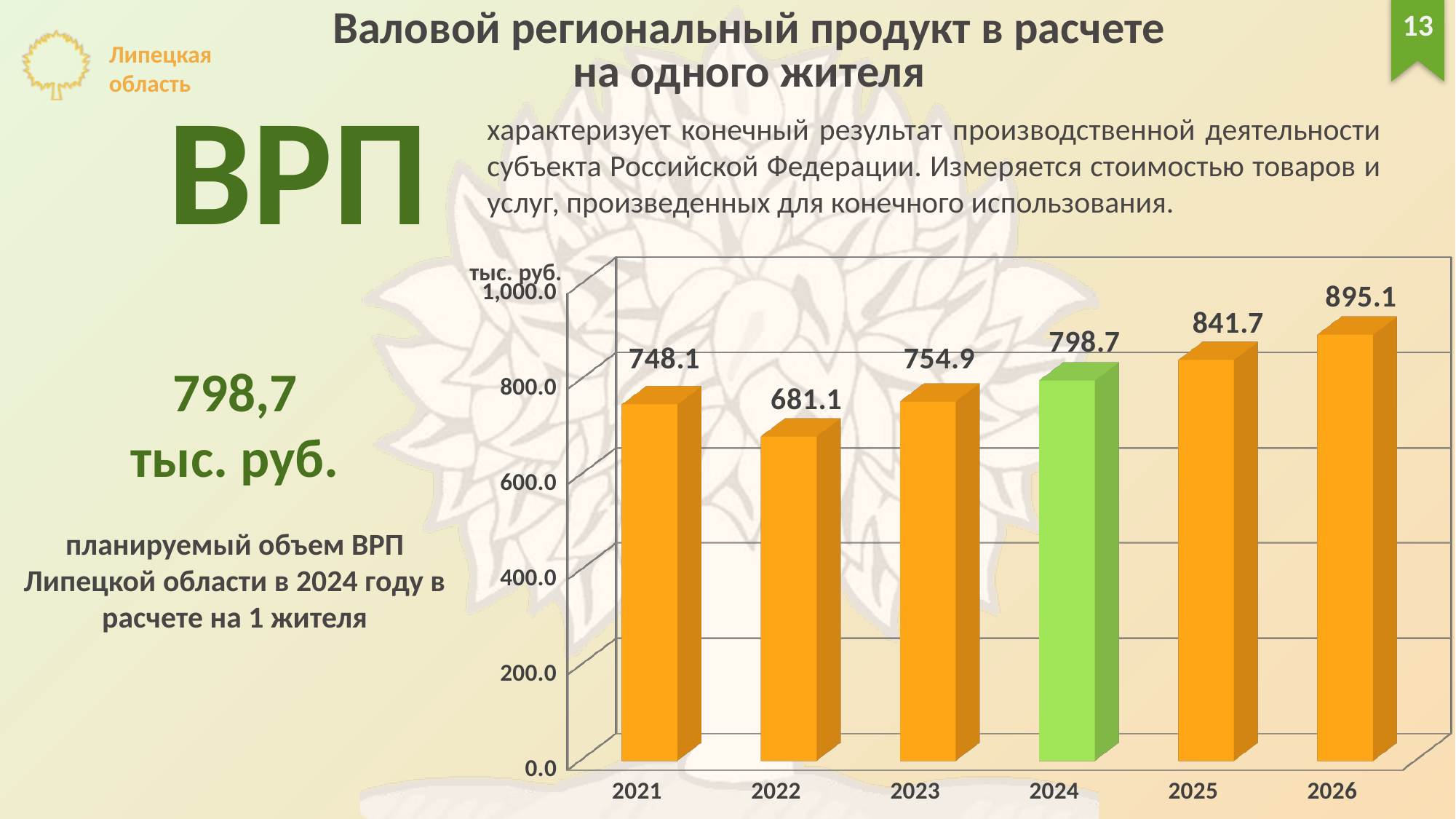
Which year has the highest value on the chart? 2026 What is the value for 2021 on the chart? 748.1 Which bar on the chart is coloured green rather than orange? 2024 Which year has the lowest value on the chart? 2022 What is the value for 2022 on the chart? 681.1 What is the difference between the values for 2021 and 2022? 67.0 How many years are shown on the x axis of the chart? 6 What is the value for 2026 on the chart? 895.1 What kind of chart is shown on the slide? bar chart Is the value for 2024 greater or less than 600.0? greater Which is larger, the value for 2023 or the value for 2021? 2023 What is the difference between the values for 2026 and 2025? 53.4